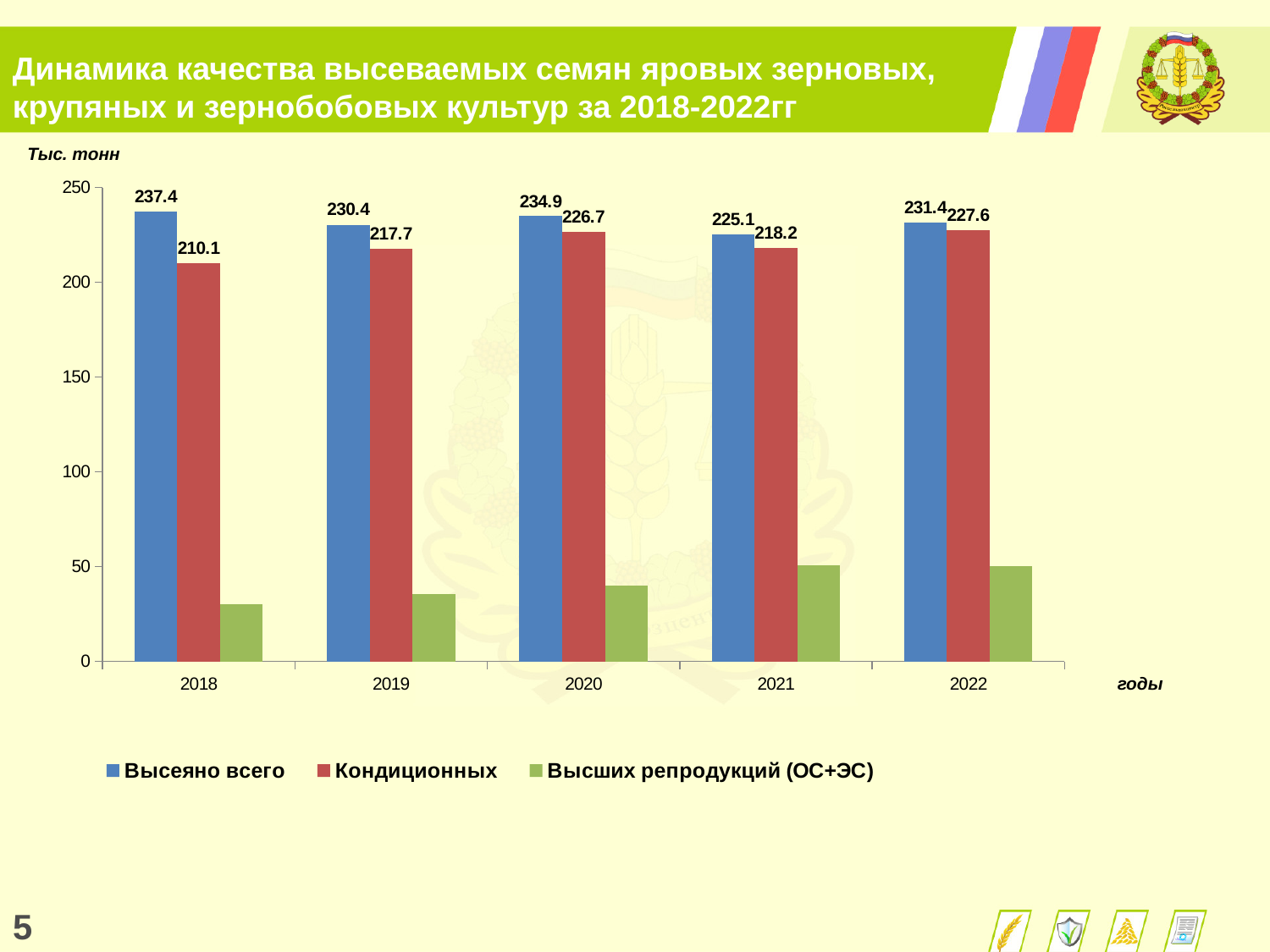
What type of chart is shown on the slide? bar chart In which year is Высеяно всего the highest? 2018 Is the value for Высших репродукций (ОС+ЭС) in 2018 greater or less than 50? less What is the difference between Высеяно всего and Кондиционных in 2018? 27.3 Which is larger in 2021: Высеяно всего or Кондиционных? Высеяно всего How many years are shown on the x axis? 5 What is the value of Высеяно всего for 2018? 237.4 What unit is given for the vertical axis? Тыс. тонн What is the value of Кондиционных for 2022? 227.6 How many series does the legend list? 3 In which year is Кондиционных the lowest? 2018 What is the value of Кондиционных for 2020? 226.7